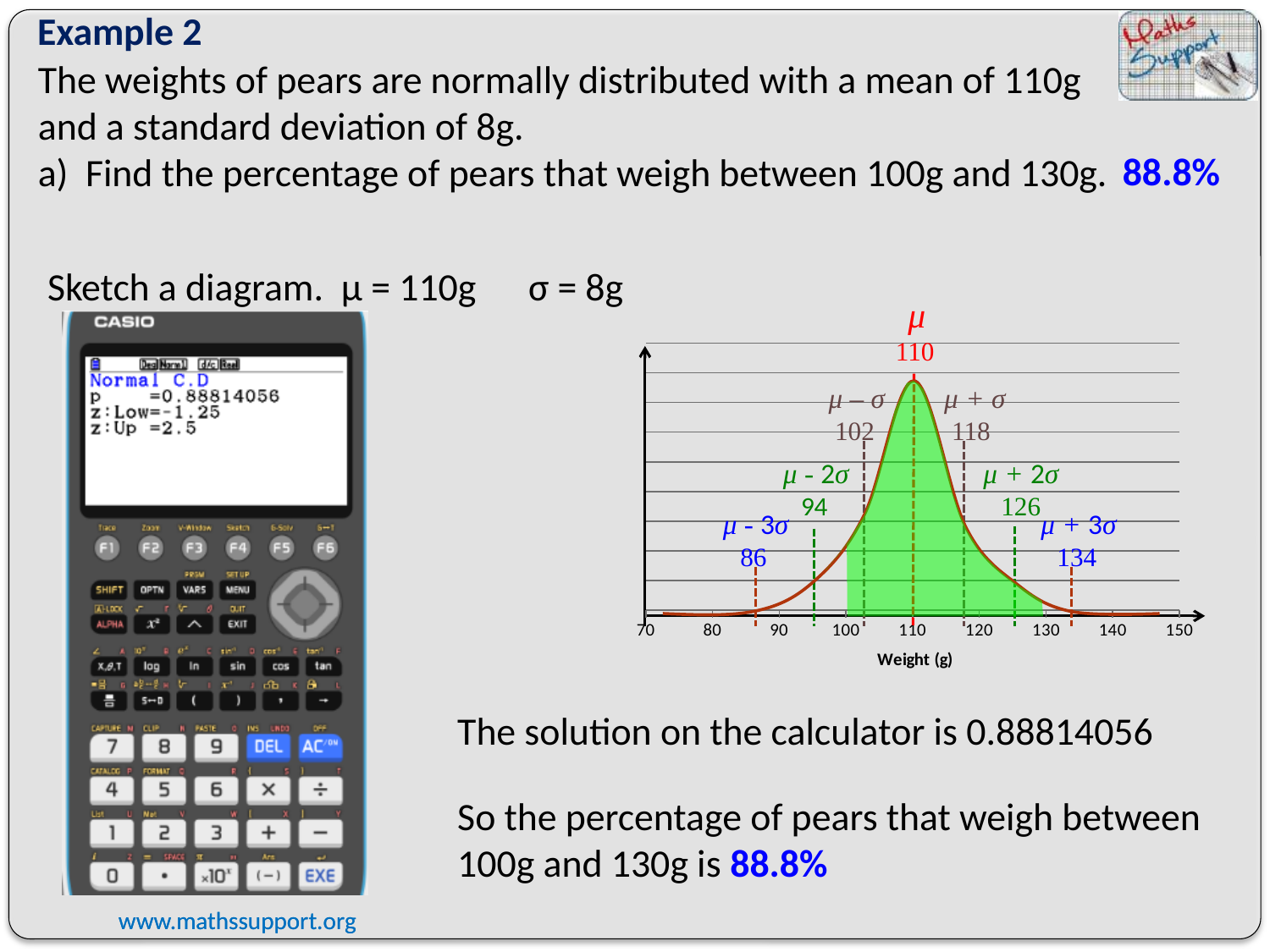
Between which two weights is the region under the curve shaded green? 100 and 130 What is the label on the horizontal axis of the chart? Weight (g) What is the difference between the values marked at μ + 3σ and μ − 3σ? 48 What kind of chart is shown on the slide? line chart (normal distribution curve) What value is marked at μ − σ on the chart? 102 What value is marked at μ − 3σ on the chart? 86 What value is marked at μ + 2σ on the chart? 126 What value is marked at μ + 3σ on the chart? 134 Which is larger, the value marked at μ + σ or the value marked at μ − 2σ? μ + σ (118) How many labelled tick marks are on the horizontal axis? 9 Does the curve rise or fall as weight increases from 110 to 150? fall At what weight does the curve reach its peak? 110